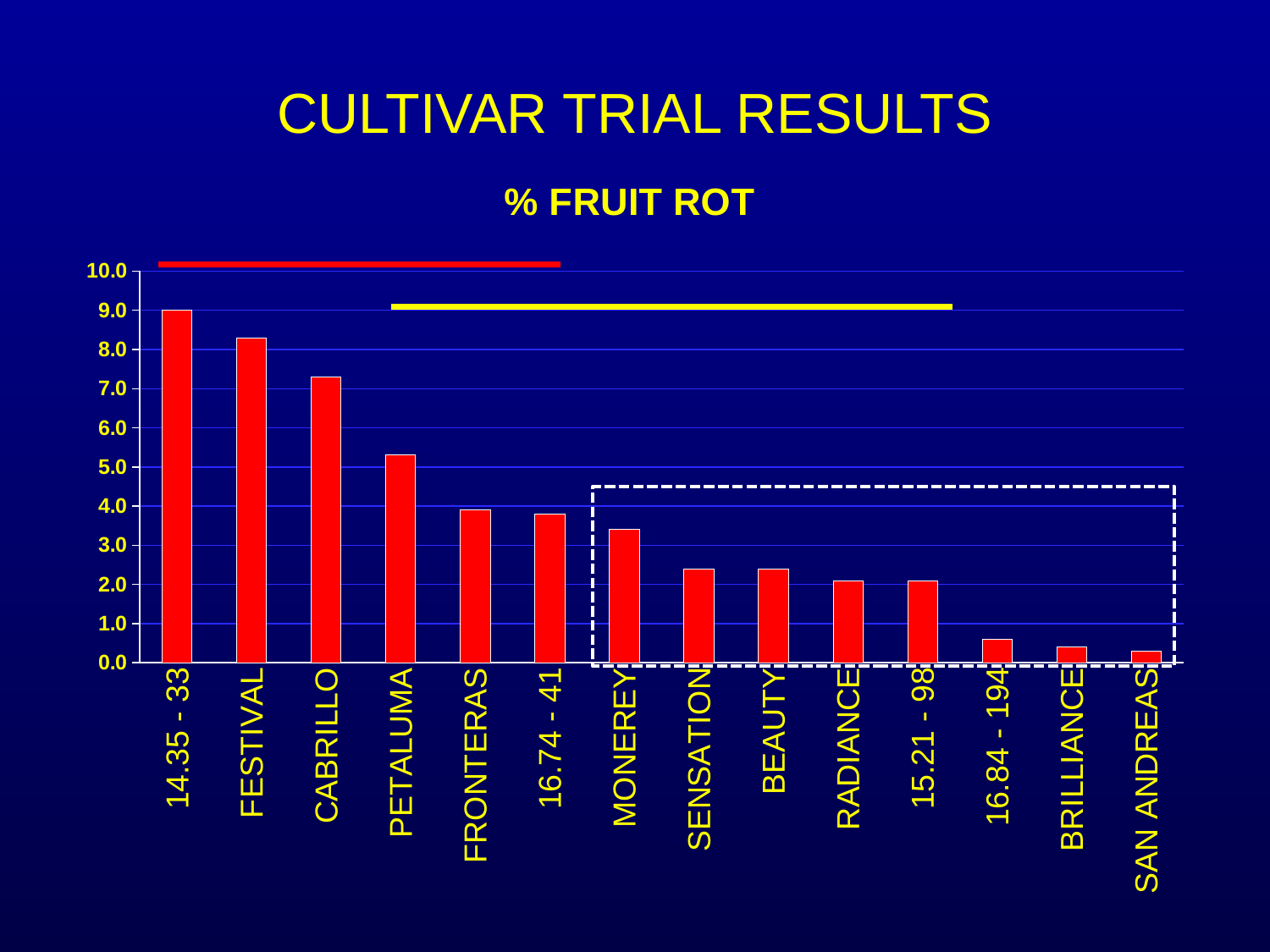
Do the % fruit rot values rise or fall moving from left to right across the cultivars? fall What kind of chart is shown on the slide? bar chart What is the title of the chart? % FRUIT ROT Is the % fruit rot for PETALUMA greater or less than 5.0? greater Is the % fruit rot for FESTIVAL greater or less than 8.0? greater Is the % fruit rot for CABRILLO greater or less than 7.0? greater Which cultivar has the highest % fruit rot? 14.35 - 33 Which has a higher % fruit rot, FESTIVAL or CABRILLO? FESTIVAL How many cultivars (bars) are plotted in the chart? 14